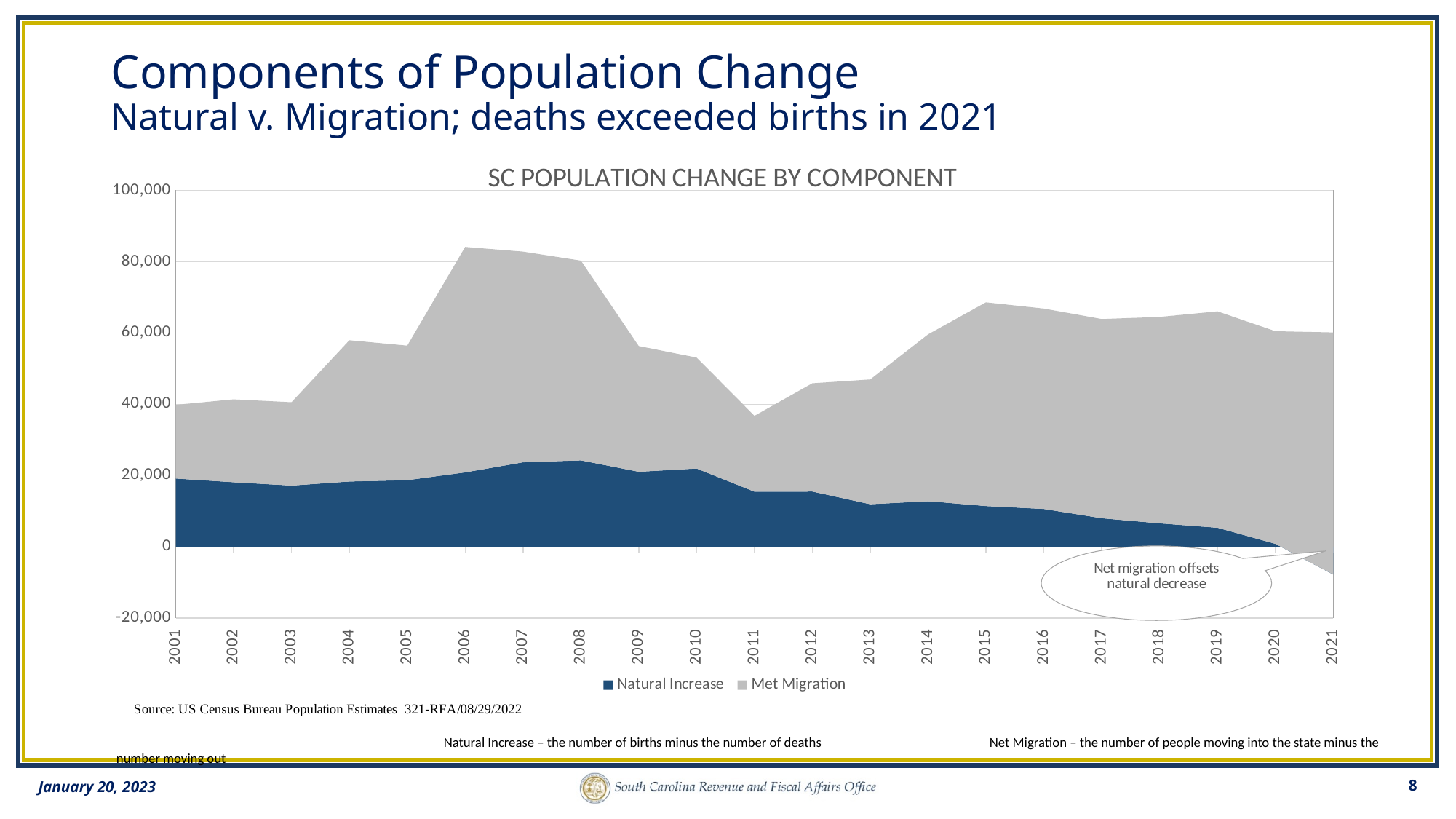
What type of chart is shown on the slide? Stacked area chart How many years are plotted along the x axis of the chart? 21 What is the title of the chart? SC POPULATION CHANGE BY COMPONENT Does the Natural Increase series rise or fall from 2008 to 2021? fall Is the Natural Increase value in 2019 greater or less than 10,000? less Between 2005 and 2020, in which year is the total population change lowest? 2011 How many series does the chart legend list? 2 Is the total population change in 2006 greater or less than 80,000? greater Which series is shown in dark blue in the chart? Natural Increase Is the total population change in 2011 greater or less than 40,000? less In which year does the total population change (top of the stacked area) reach its highest point? 2006